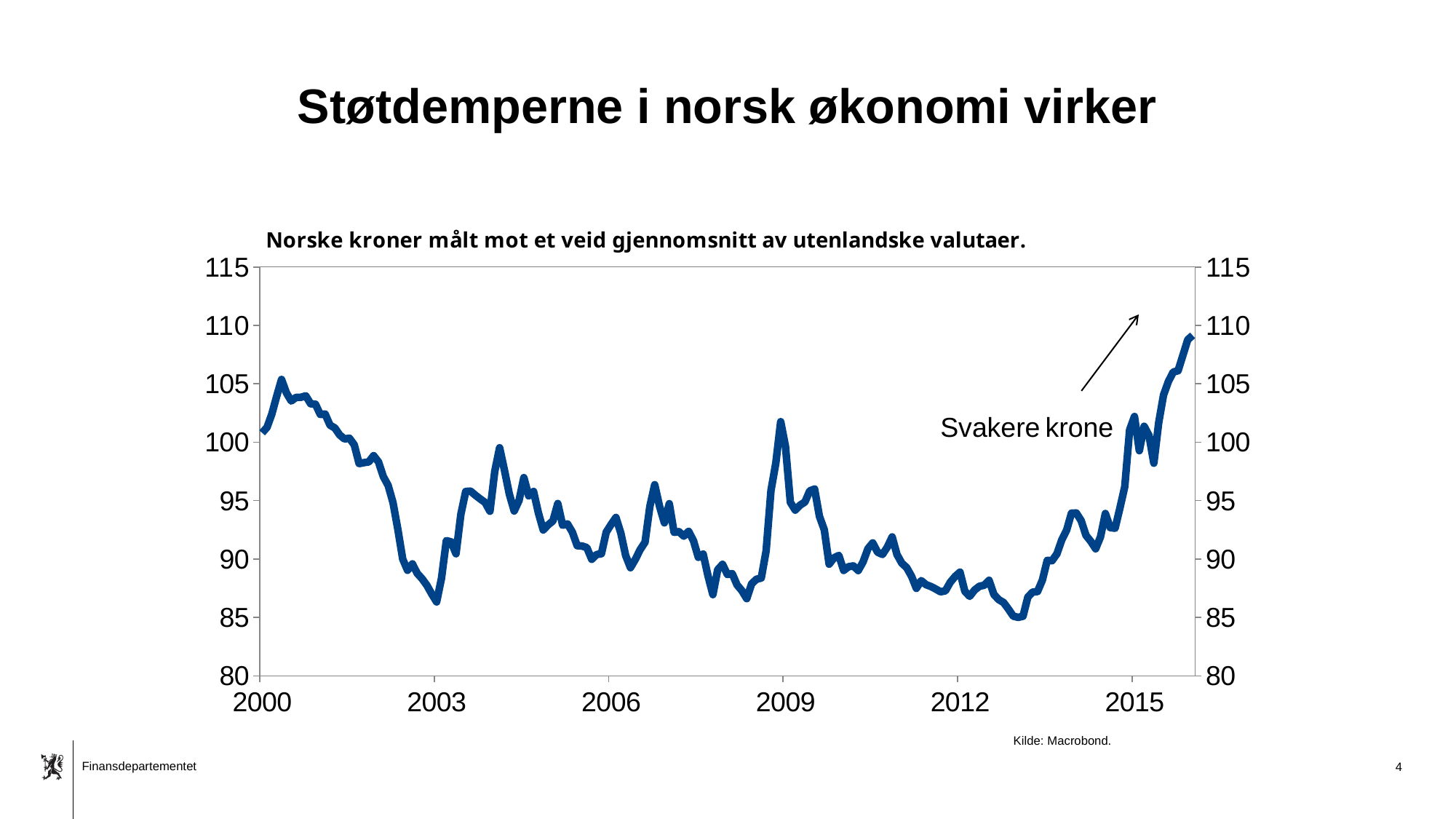
Is the lowest point of the line, around 2013, greater or less than 90? less Does the line rise or fall between 2000 and 2003? fall Is the peak value around the start of 2009 greater or less than 100? greater Is the value at the start of 2012 greater or less than 90? less Does the line rise or fall between 2013 and the end of the series? rise What is the subtitle (chart title) printed above the chart? Norske kroner målt mot et veid gjennomsnitt av utenlandske valutaer. What source is cited below the chart? Kilde: Macrobond. How many year labels are shown on the x axis? 6 What kind of chart is shown on the slide? line chart Is the value at the end of the series higher or lower than the peak reached in 2000? higher